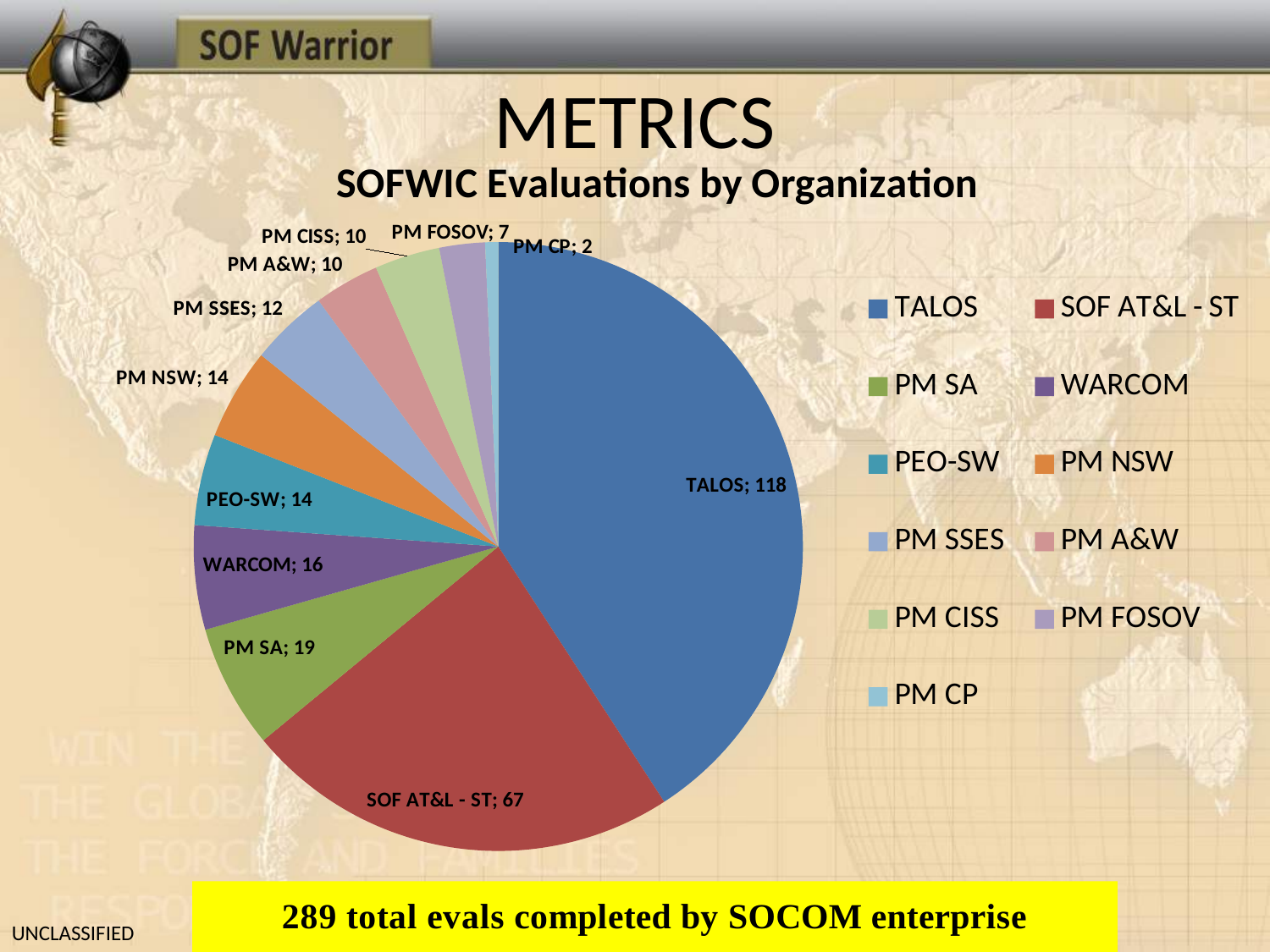
What is the title of the chart on the slide? SOFWIC Evaluations by Organization Which is larger, the value for PM SSES or the value for PM A&W? PM SSES How many evaluations does the pie chart show for TALOS? 118 What type of chart is shown on the slide? Pie chart What is the difference between the PM SA value and the WARCOM value? 3 Which organization has the smallest slice in the pie chart? PM CP How many organizations are shown as slices in the pie chart? 11 What value is shown for SOF AT&L - ST in the pie chart? 67 What is the difference between the TALOS value and the SOF AT&L - ST value? 51 Which organization has the largest slice in the pie chart? TALOS What value is shown for PM FOSOV in the pie chart? 7 What value is shown for WARCOM in the pie chart? 16